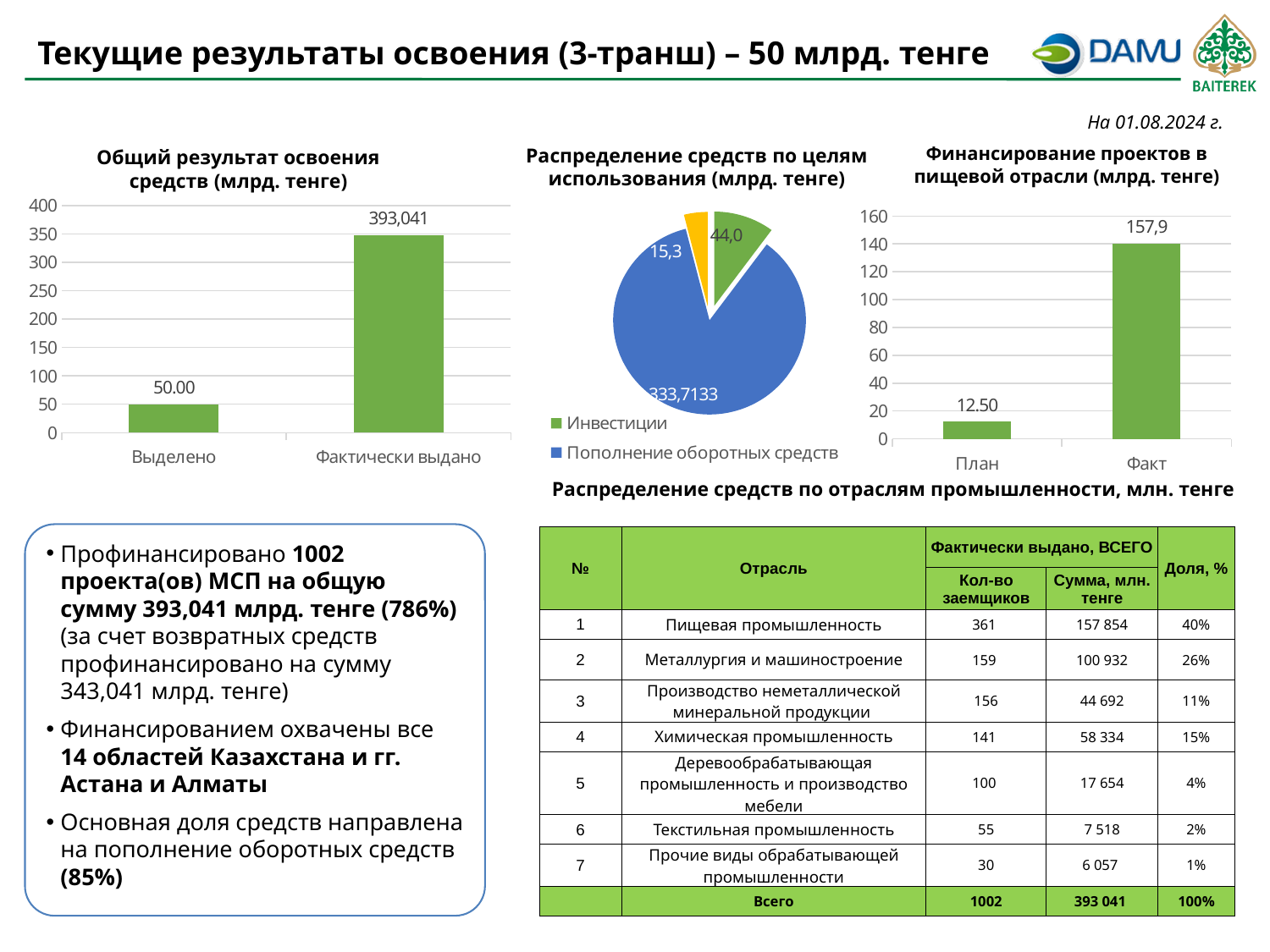
In the chart 'Финансирование проектов в пищевой отрасли (млрд. тенге)', what is the value for 'План'? 12.50 In the chart 'Общий результат освоения средств (млрд. тенге)', how many categories are shown on the x axis? 2 In the pie chart 'Распределение средств по целям использования (млрд. тенге)', what is the value of the 'Инвестиции' slice? 44,0 In the chart 'Финансирование проектов в пищевой отрасли (млрд. тенге)', what is the value for 'Факт'? 157,9 What kind of chart is 'Общий результат освоения средств (млрд. тенге)'? Bar chart In the pie chart 'Распределение средств по целям использования (млрд. тенге)', what colour is the 'Инвестиции' slice? Green In the chart 'Общий результат освоения средств (млрд. тенге)', what is the value for 'Выделено'? 50.00 In the pie chart 'Распределение средств по целям использования (млрд. тенге)', which slice is the largest? Пополнение оборотных средств In the chart 'Общий результат освоения средств (млрд. тенге)', which category has the higher value? Фактически выдано In the pie chart 'Распределение средств по целям использования (млрд. тенге)', what is the value of the 'Пополнение оборотных средств' slice? 333,7133 In the chart 'Общий результат освоения средств (млрд. тенге)', what is the value for 'Фактически выдано'? 393,041